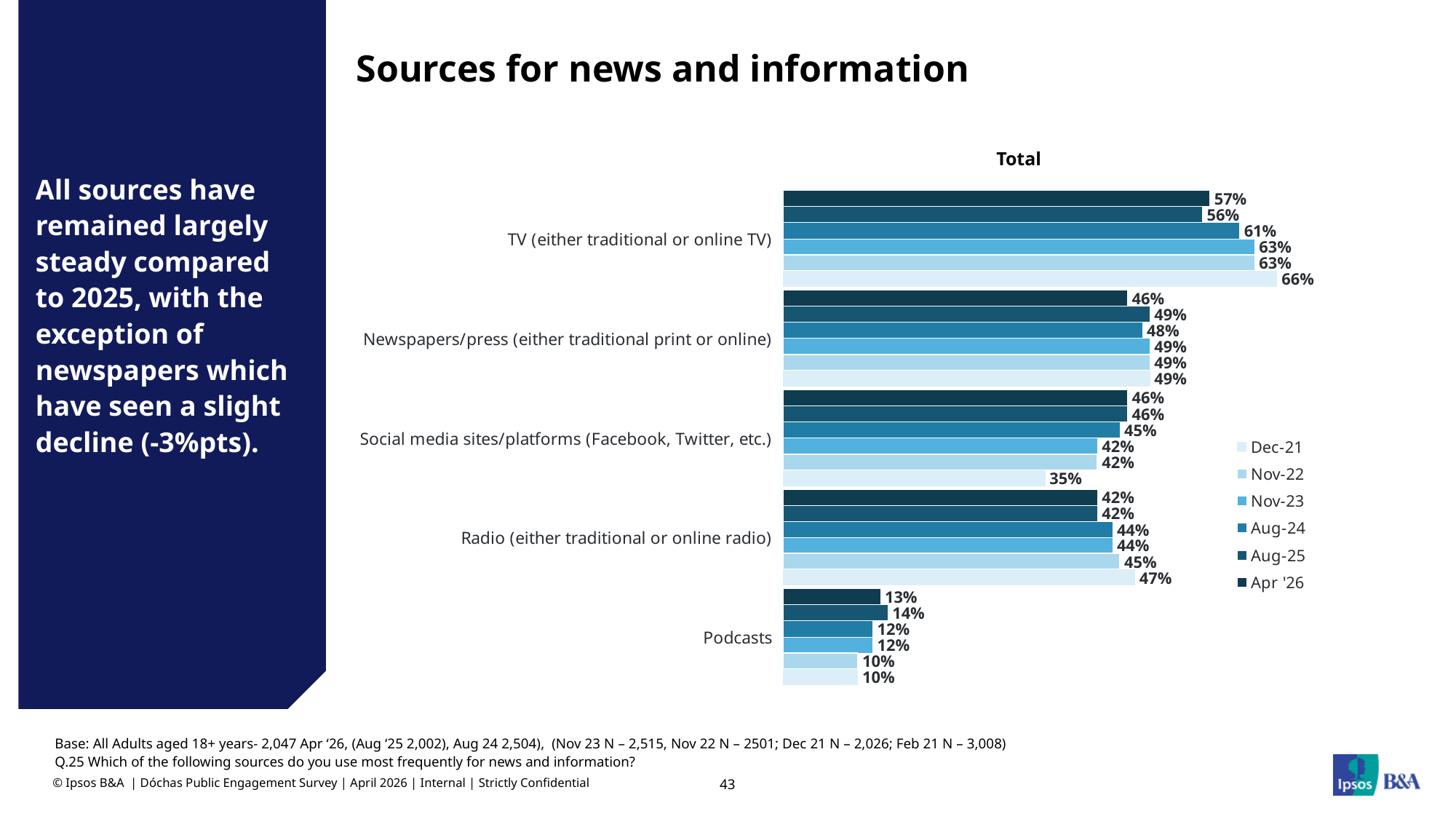
What is the Apr '26 value for TV (either traditional or online TV)? 57% Which news source has the highest values across all waves? TV (either traditional or online TV) What is the difference between the Dec-21 and Apr '26 values for TV (either traditional or online TV)? 9% What is the Dec-21 value for Social media sites/platforms (Facebook, Twitter, etc.)? 35% How many news sources (categories) are shown in the chart? 5 What is the Apr '26 value for Newspapers/press (either traditional print or online)? 46% What is the title of the chart? Sources for news and information Which is larger for Apr '26: the value for Radio (either traditional or online radio) or the value for Social media sites/platforms? Social media sites/platforms Which news source has the lowest values across all waves? Podcasts What kind of chart is shown on the slide? bar chart How many series does the legend list? 6 What is the Aug-25 value for Podcasts? 14%